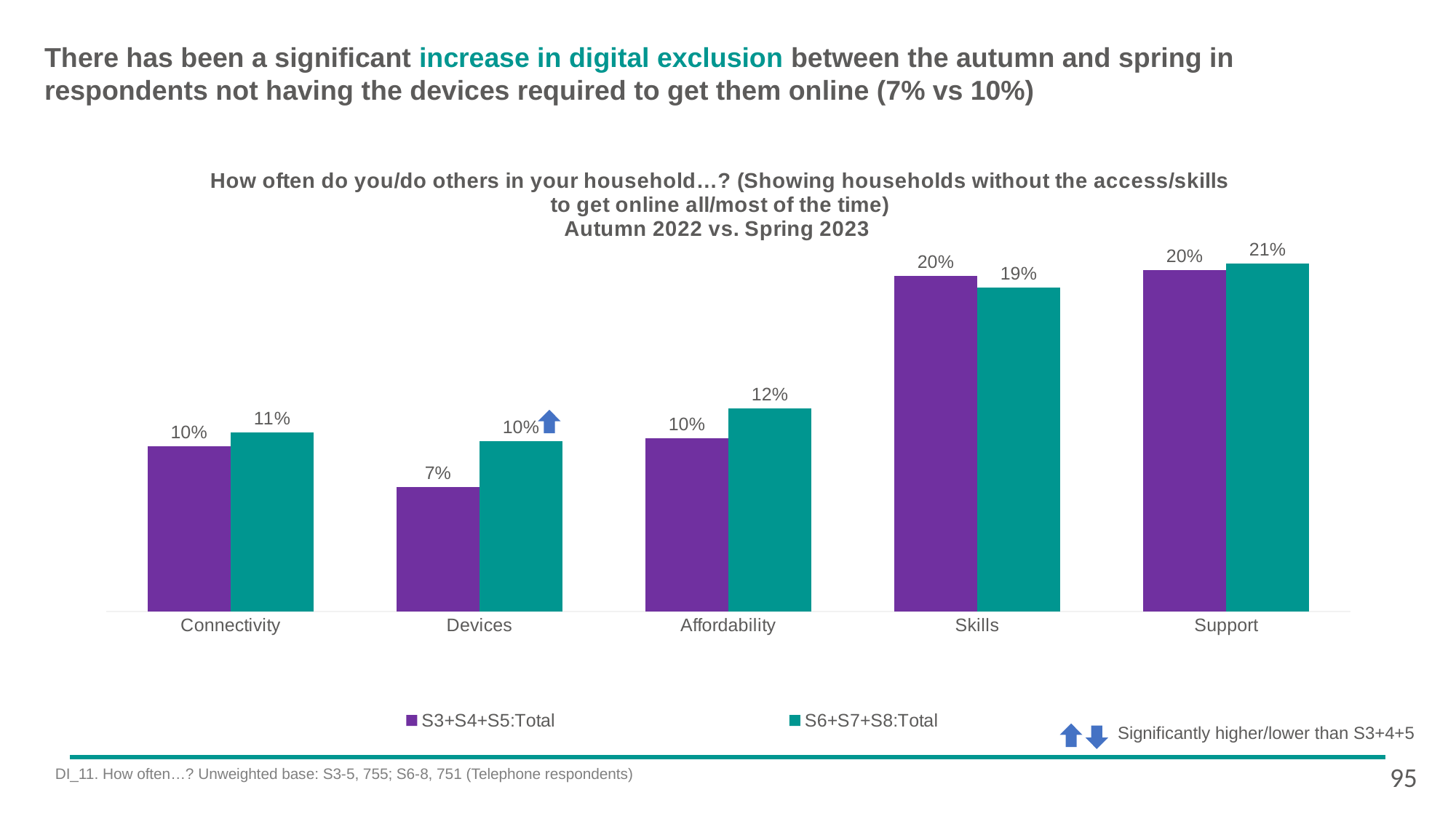
What is the value for Devices in the S3+S4+S5:Total series? 7% How many series does the legend list? 2 What is the difference between the S6+S7+S8:Total and S3+S4+S5:Total values for Devices? 3% For Skills, which series has the larger value, S3+S4+S5:Total or S6+S7+S8:Total? S3+S4+S5:Total What is the value for Affordability in the S6+S7+S8:Total series? 12% How many categories are shown on the x axis? 5 Which category has the highest value in the S6+S7+S8:Total series? Support What is the value for Skills in the S3+S4+S5:Total series? 20% What kind of chart is shown on the slide? Bar chart Which category has the lowest value in the S3+S4+S5:Total series? Devices What is the value for Support in the S6+S7+S8:Total series? 21% Which category has a blue arrow marking a significantly higher value than S3+4+5? Devices